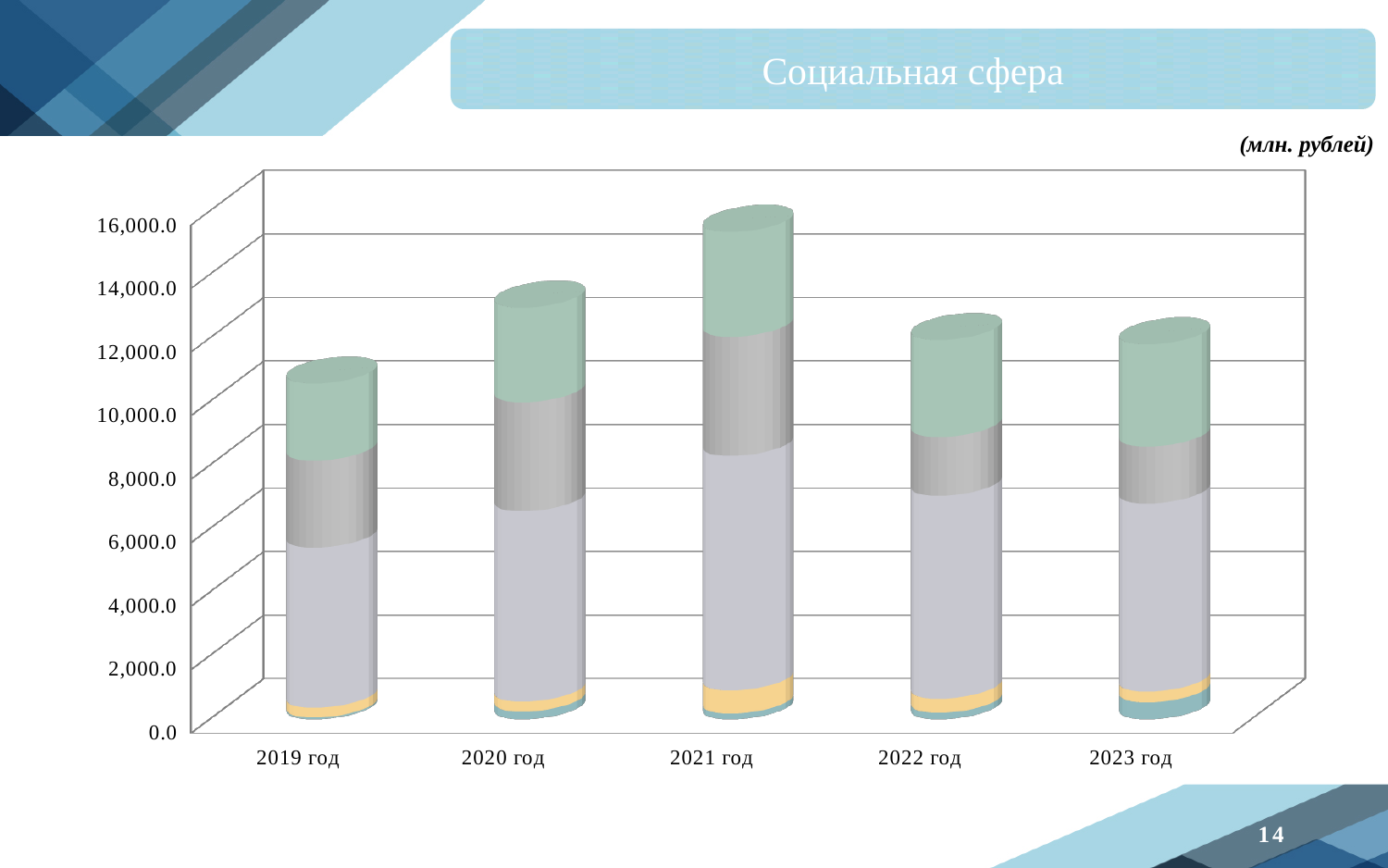
Is the total value for 2021 год greater or less than 14,000.0? greater Is the total value for 2019 год greater or less than 12,000.0? less Which year has the lowest total bar on the chart? 2019 год Which total bar is larger, 2020 год or 2021 год? 2021 год Does the total value rise or fall from 2019 год to 2021 год? rise Which year has the highest total bar on the chart? 2021 год What kind of chart is shown on the slide? Stacked bar chart How many years (categories) are shown on the x axis of the chart? 5 Is the total value for 2022 год greater or less than 10,000.0? greater What is the title of the chart on the slide? Социальная сфера In what units are the values on the chart expressed? млн. рублей